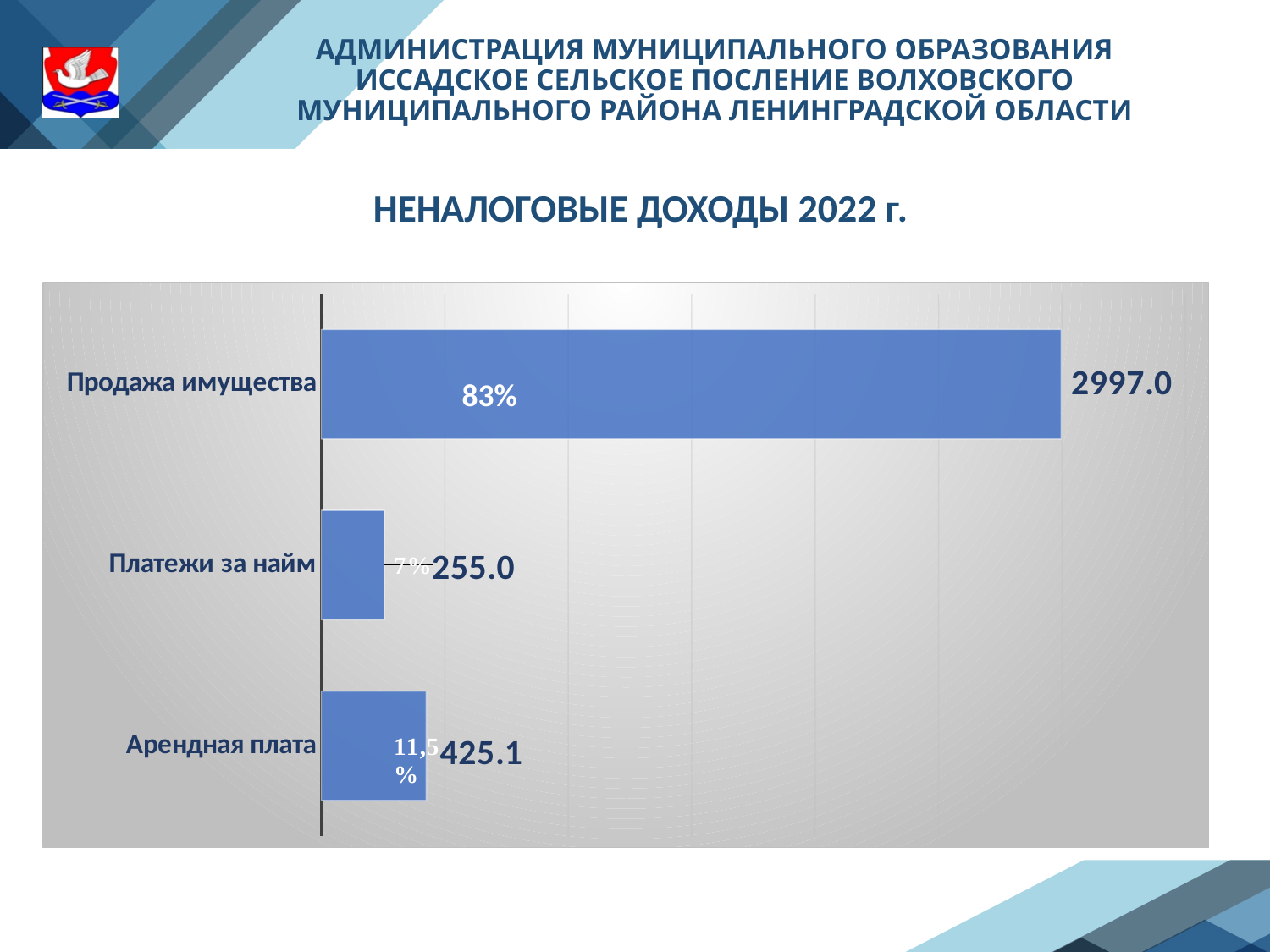
How many categories are shown in the chart? 3 What is the value for Арендная плата? 425.1 Which category has the highest value? Продажа имущества Which is larger, the value for Арендная плата or the value for Платежи за найм? Арендная плата What type of chart is shown on the slide? Bar chart What is the value for Продажа имущества? 2997.0 What percentage share is shown on the bar for Продажа имущества? 83% Which category has the lowest value? Платежи за найм What is the difference between the values for Продажа имущества and Платежи за найм? 2742.0 What percentage share is shown on the bar for Арендная плата? 11,5% What is the difference between the values for Арендная плата and Платежи за найм? 170.1 What is the value for Платежи за найм? 255.0